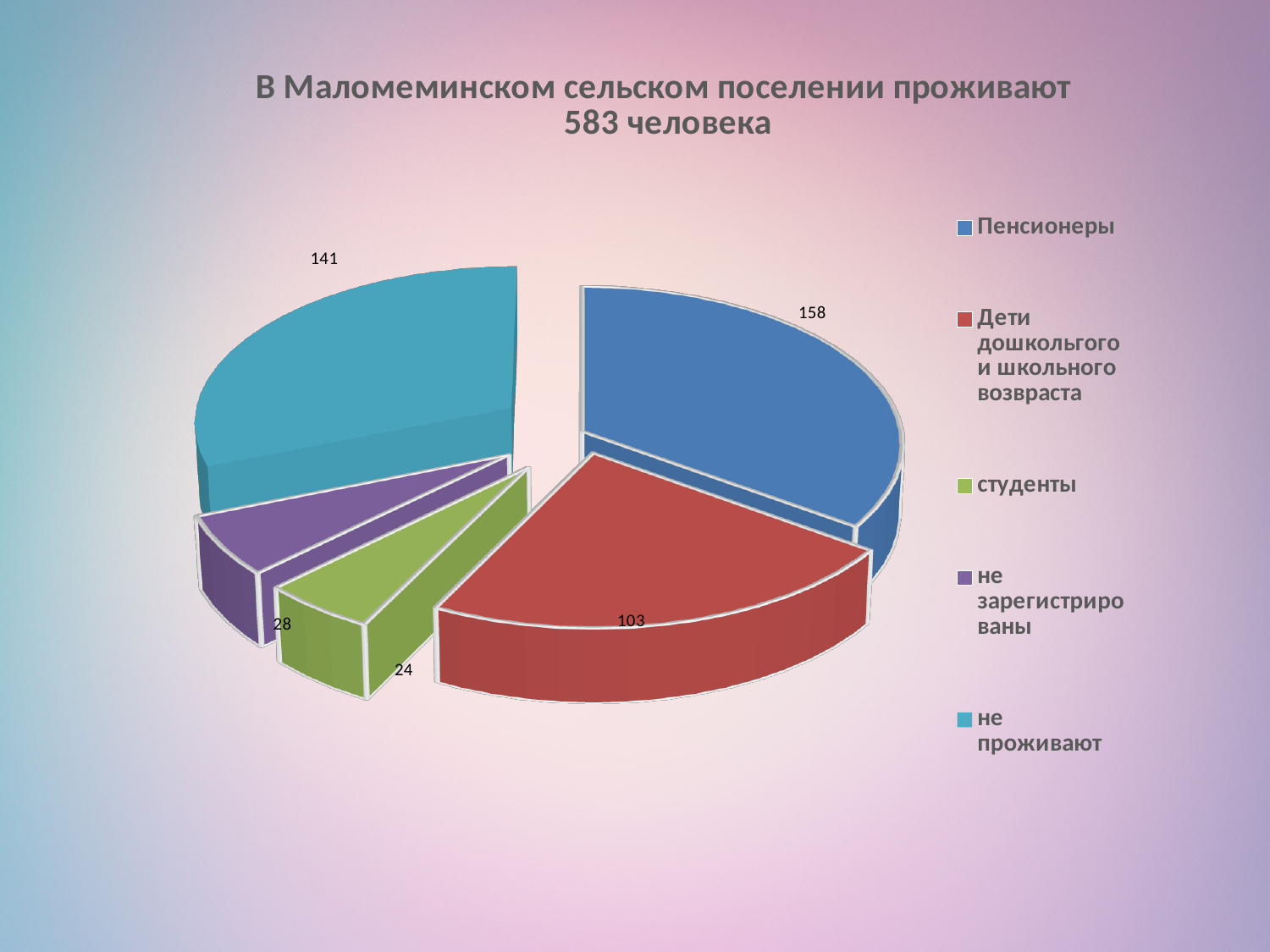
What value is shown for Пенсионеры? 158 What value is shown for не проживают? 141 How many categories does the pie chart show? 5 What value is shown for студенты? 24 Which category has the largest slice? Пенсионеры What value is shown for Дети дошкольного и школьного возраста? 103 Which is larger, the value for не зарегистрированы or the value for студенты? не зарегистрированы Which category has the smallest slice? студенты What colour is the slice for не проживают? light blue What value is shown for не зарегистрированы? 28 What is the difference between the values for Пенсионеры and не проживают? 17 What kind of chart is shown on the slide? pie chart